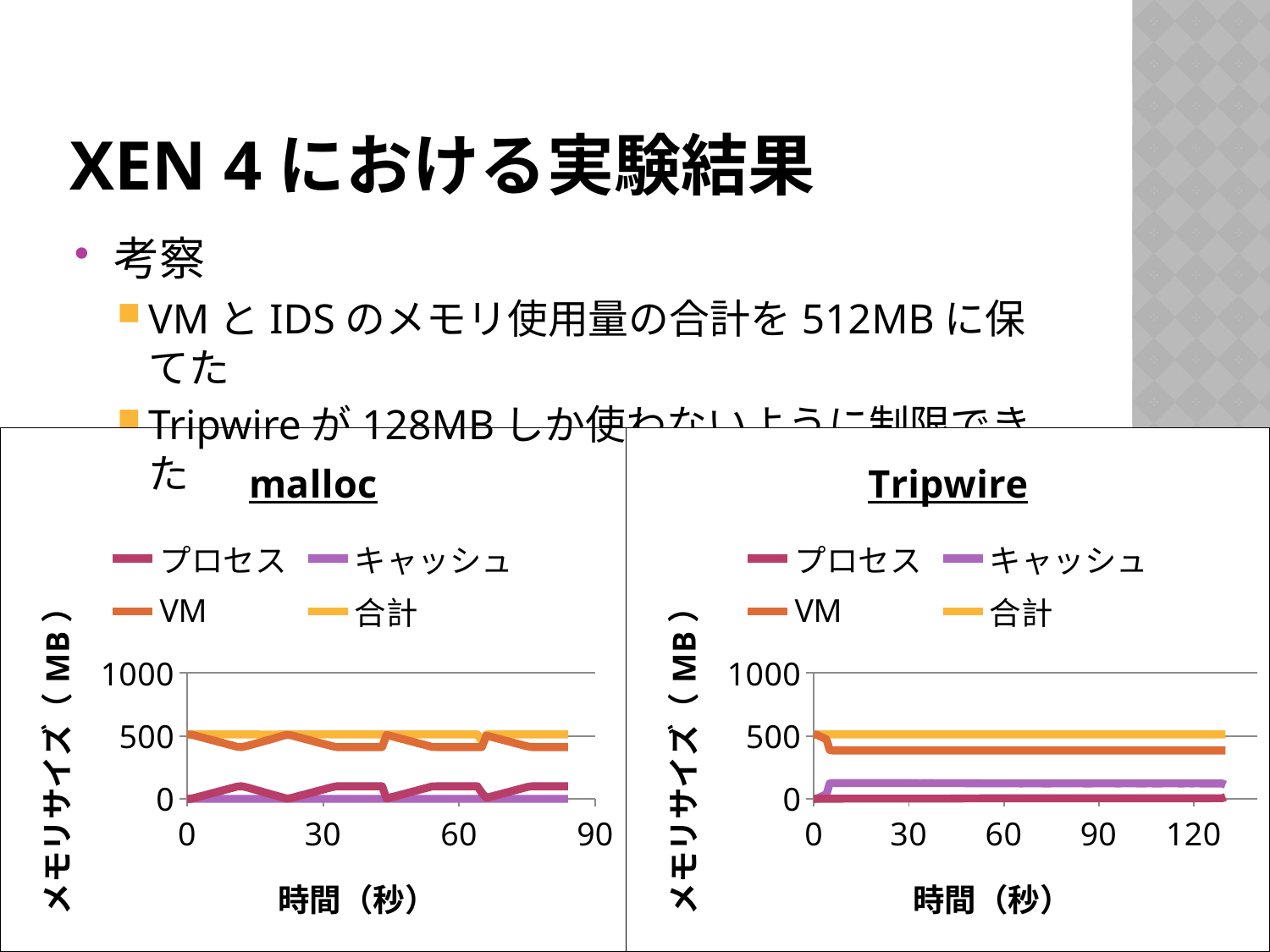
In the malloc chart, is the value of プロセス greater or less than 500? less What kind of chart is the malloc chart? line chart In the Tripwire chart, which series has the lowest values? プロセス What is the label of the y axis on the malloc chart? メモリサイズ（MB） In the Tripwire chart, is the value of キャッシュ greater or less than 500? less In the Tripwire chart, is the value of VM after the first few seconds greater or less than 500? less What kind of chart is the Tripwire chart? line chart How many series does the legend of the Tripwire chart list? 4 How many series does the legend of the malloc chart list? 4 In the malloc chart, which series has the highest values? 合計 In the Tripwire chart, which is larger, VM or キャッシュ? VM